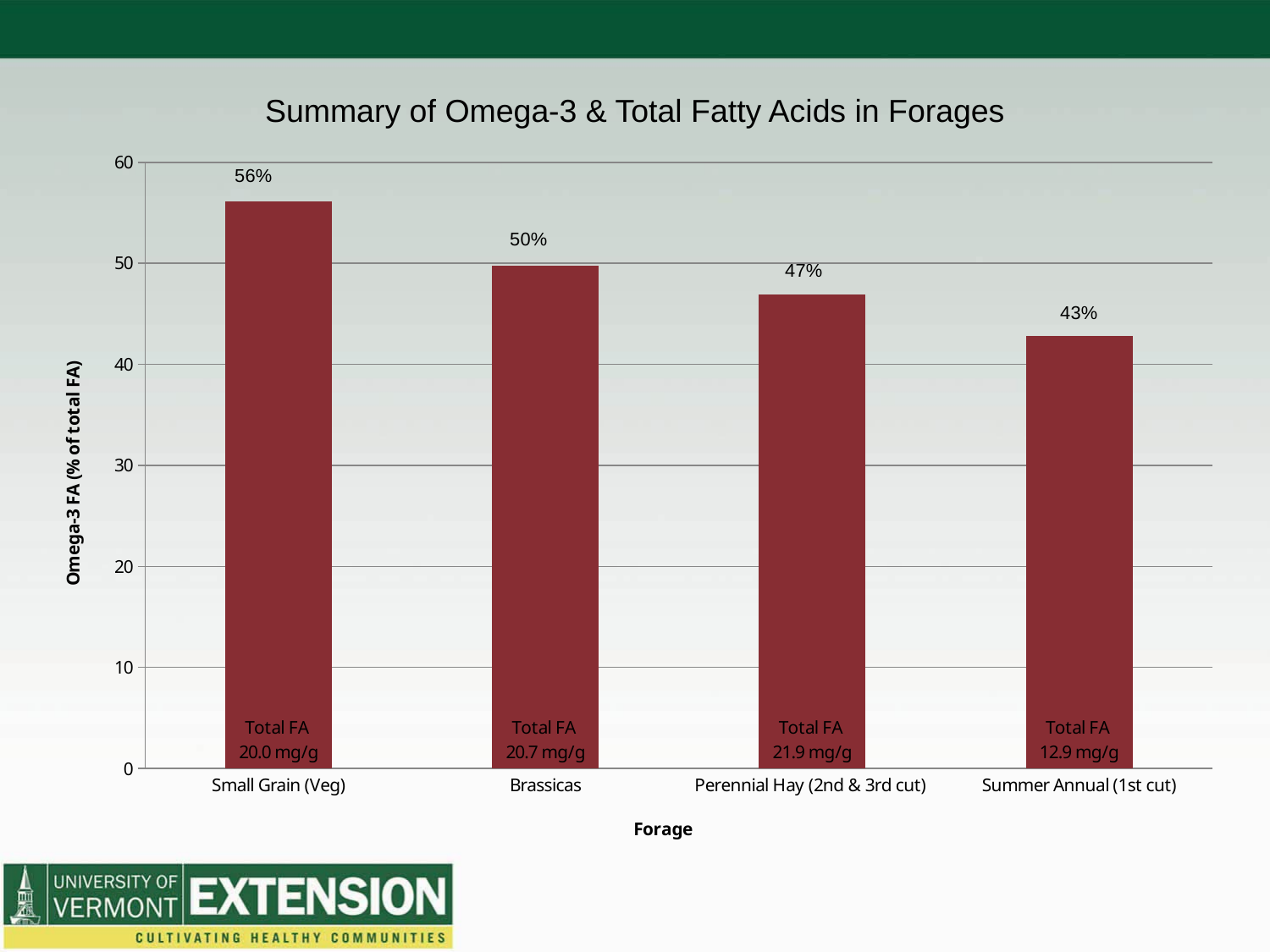
Which forage has the lowest Omega-3 FA percentage? Summer Annual (1st cut) What is the title of the chart? Summary of Omega-3 & Total Fatty Acids in Forages Do the Omega-3 FA percentages rise or fall from left to right across the forages? Fall Which has a higher Omega-3 FA percentage, Brassicas or Perennial Hay (2nd & 3rd cut)? Brassicas What is the Omega-3 FA percentage for Small Grain (Veg)? 56% How many forage categories are shown in the chart? 4 What is the Total FA value printed on the bar for Perennial Hay (2nd & 3rd cut)? 21.9 mg/g What is the Omega-3 FA percentage for Summer Annual (1st cut)? 43% What type of chart is shown on the slide? Bar chart What is the difference in Omega-3 FA percentage between Small Grain (Veg) and Summer Annual (1st cut)? 13% What is the Omega-3 FA percentage for Brassicas? 50% Which forage has the highest Omega-3 FA percentage? Small Grain (Veg)